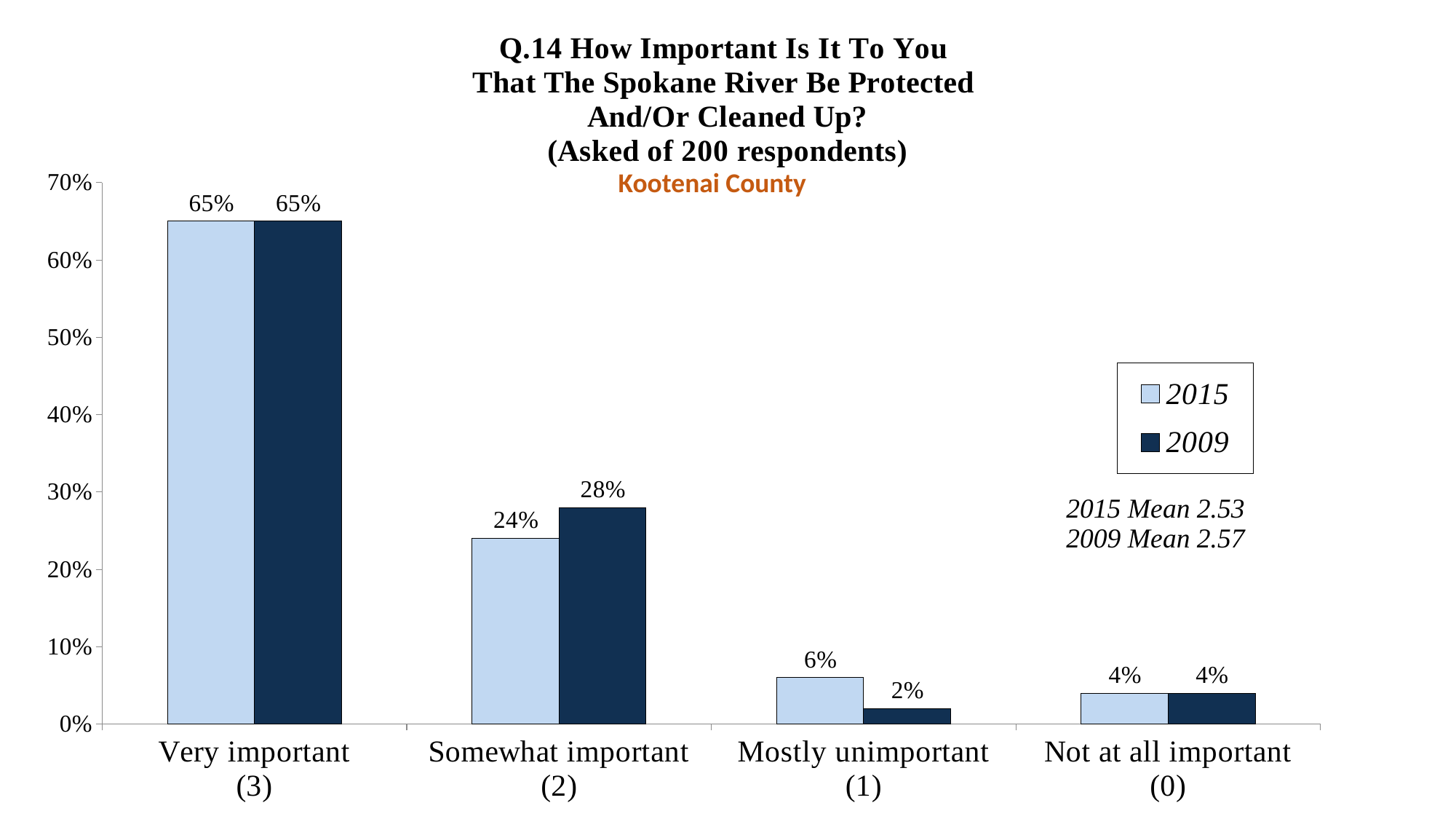
What is the difference between the 2009 and 2015 values for Somewhat important? 4% Is the 2009 value for Somewhat important greater or less than 30%? less Which category has the highest 2009 value? Very important What is the 2015 mean shown on the slide? 2.53 Which category has the lowest 2015 value? Not at all important How many series does the legend list? 2 What is the 2009 value for Mostly unimportant? 2% What kind of chart is shown on the slide? bar chart For Mostly unimportant, which series has the larger value, 2015 or 2009? 2015 How many categories are shown on the x axis? 4 What is the 2015 value for Somewhat important? 24% What is the 2015 value for Very important? 65%